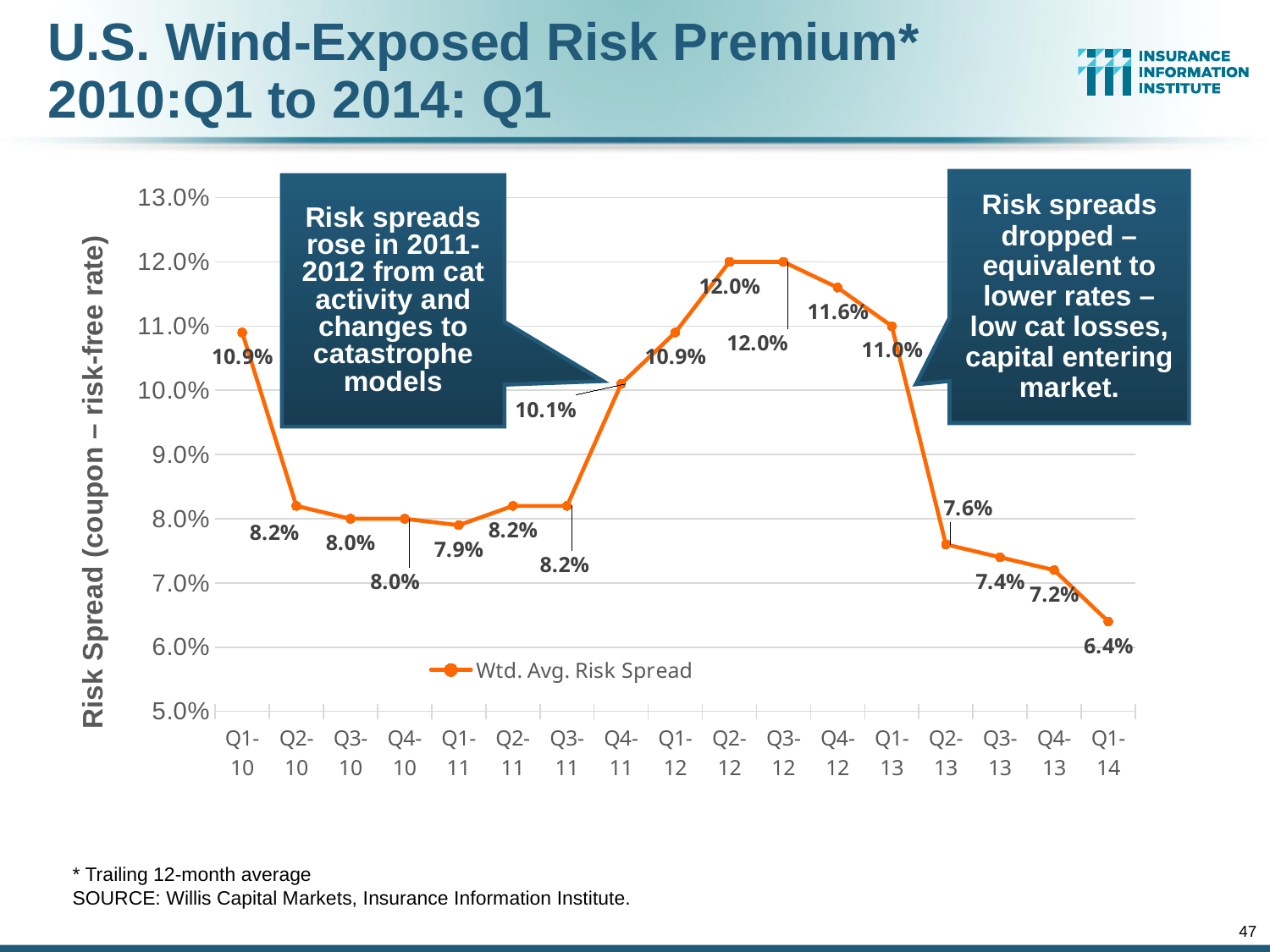
What is the weighted average risk spread for Q4-12? 11.6% What is the name of the series shown in the legend? Wtd. Avg. Risk Spread How many quarterly data points are plotted on the chart? 17 What is the difference between the risk spread in Q1-13 and Q2-13? 3.4 percentage points What is the weighted average risk spread for Q1-14? 6.4% Which quarter has the lowest weighted average risk spread? Q1-14 What kind of chart is shown on the slide? Line chart What is the weighted average risk spread for Q1-10? 10.9% How many series does the legend list? 1 What is the weighted average risk spread for Q1-11? 7.9% Which is larger, the risk spread in Q1-10 or in Q1-11? Q1-10 Do the values rise or fall from Q1-13 to Q1-14? Fall